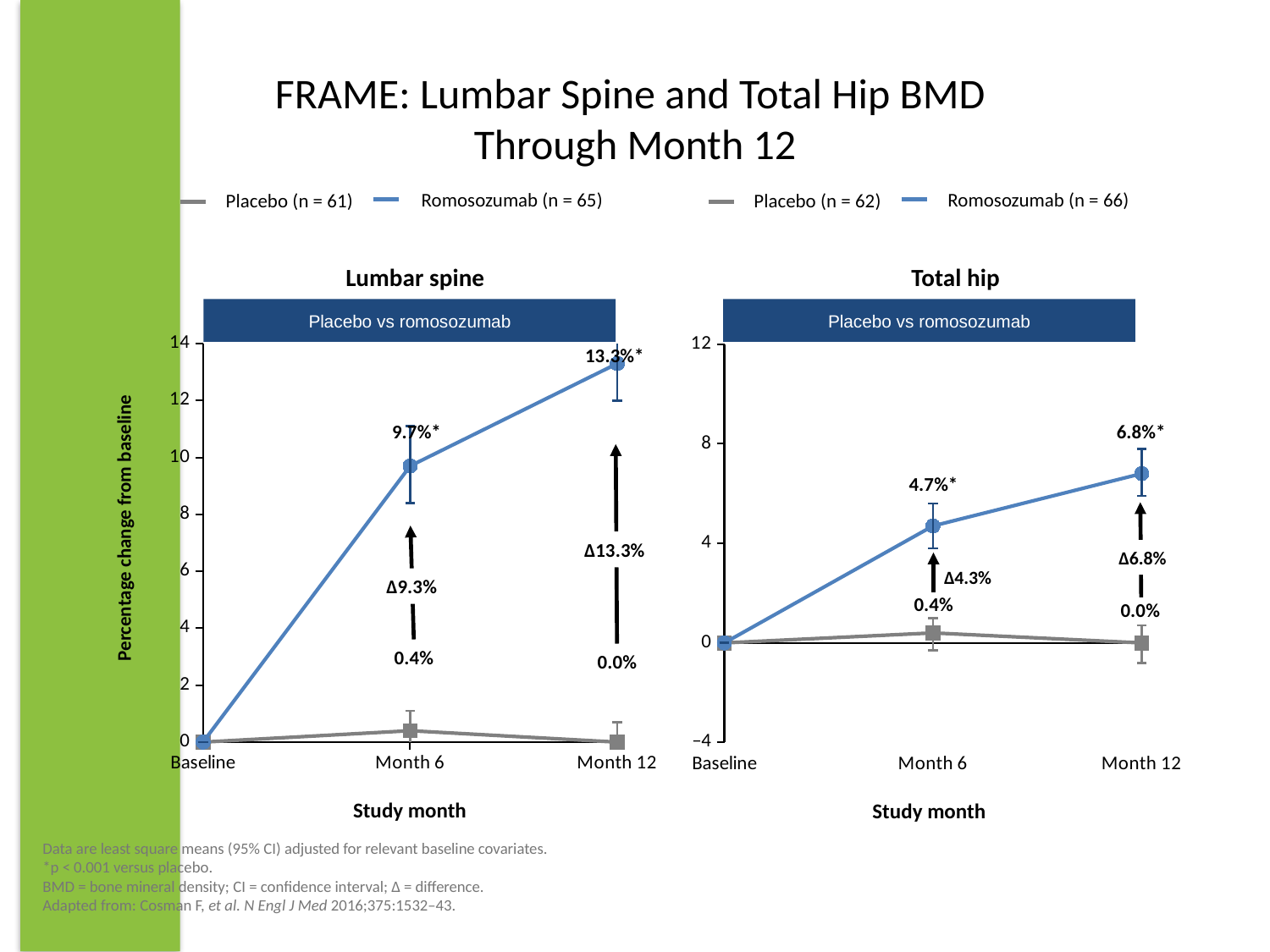
How many series does the legend list for the Lumbar spine chart? 2 What kind of chart is the Total hip chart? Line chart In the Lumbar spine chart, what is the difference between romosozumab and placebo at Month 6, as labelled on the chart? Δ9.3% In the Total hip chart, what is the percentage change from baseline for placebo at Month 6? 0.4% In the Total hip chart, which series has the higher value at Month 6, placebo or romosozumab? Romosozumab In the Lumbar spine chart, what is the percentage change from baseline for romosozumab at Month 12? 13.3% In the Lumbar spine chart, what is the percentage change from baseline for romosozumab at Month 6? 9.7% In the Total hip chart legend, how many patients are in the romosozumab group? n = 66 In the Total hip chart, what is the percentage change from baseline for romosozumab at Month 12? 6.8% In the Total hip chart, what is the difference between romosozumab and placebo at Month 12, as labelled on the chart? Δ6.8% How many study month time points are shown on the x axis of the Total hip chart? 3 In the Lumbar spine chart, does the romosozumab line rise or fall from Baseline to Month 12? Rise